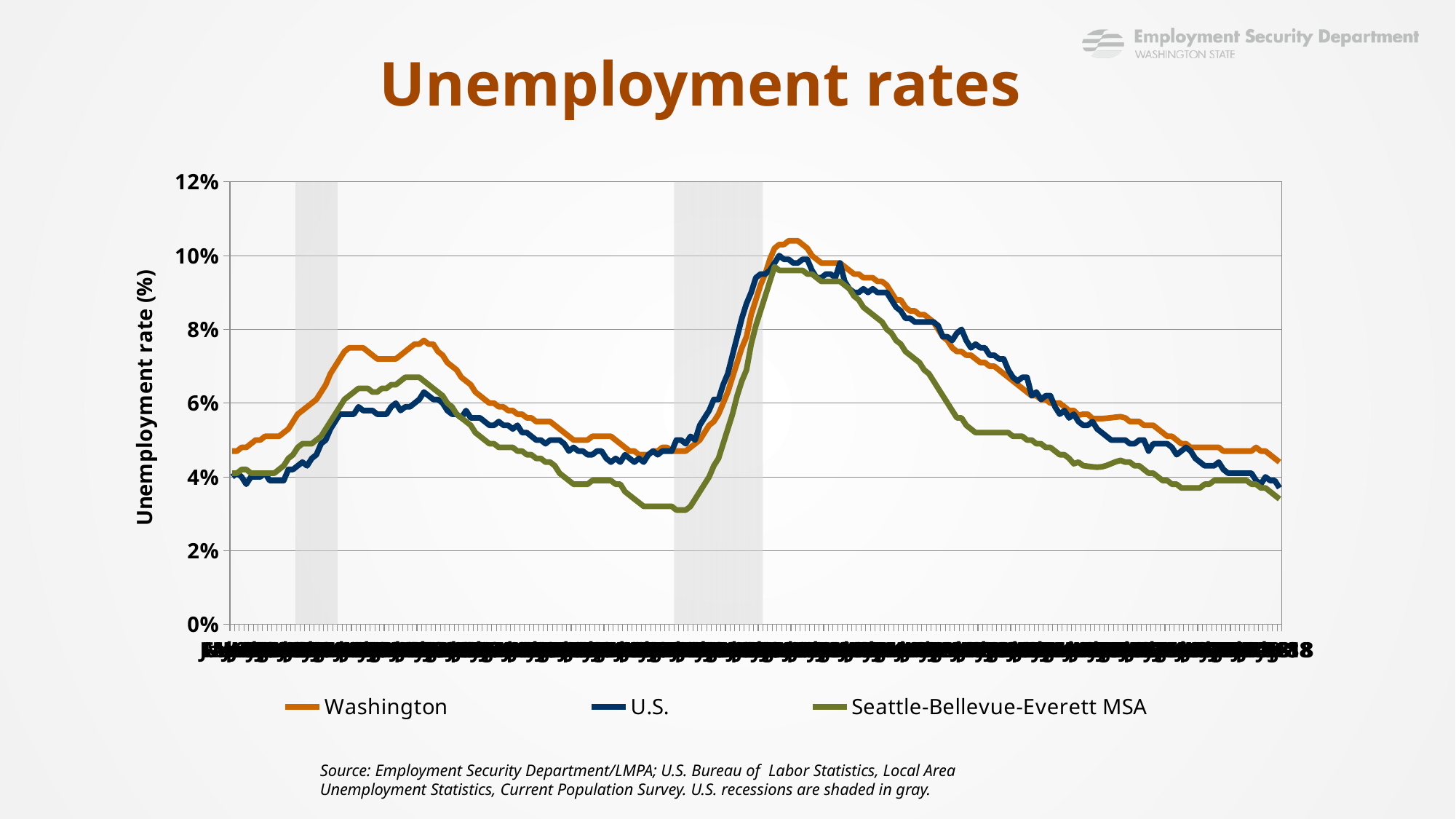
Which series reaches the highest value anywhere on the chart? Washington At the right end of the chart, which series has the lowest value? Seattle-Bellevue-Everett MSA What is the label on the vertical axis? Unemployment rate (%) Is the lowest point of the Seattle-Bellevue-Everett MSA line greater or less than 4%? less Is the highest peak of the Washington line greater or less than 10%? greater At the right end of the chart, which series has the highest value? Washington What is the title of the chart? Unemployment rates Is the highest peak of the U.S. line greater or less than 8%? greater What kind of chart is shown on the slide? line chart How many series does the legend list? 3 From its highest peak to the right end of the chart, does the Washington line rise or fall? fall